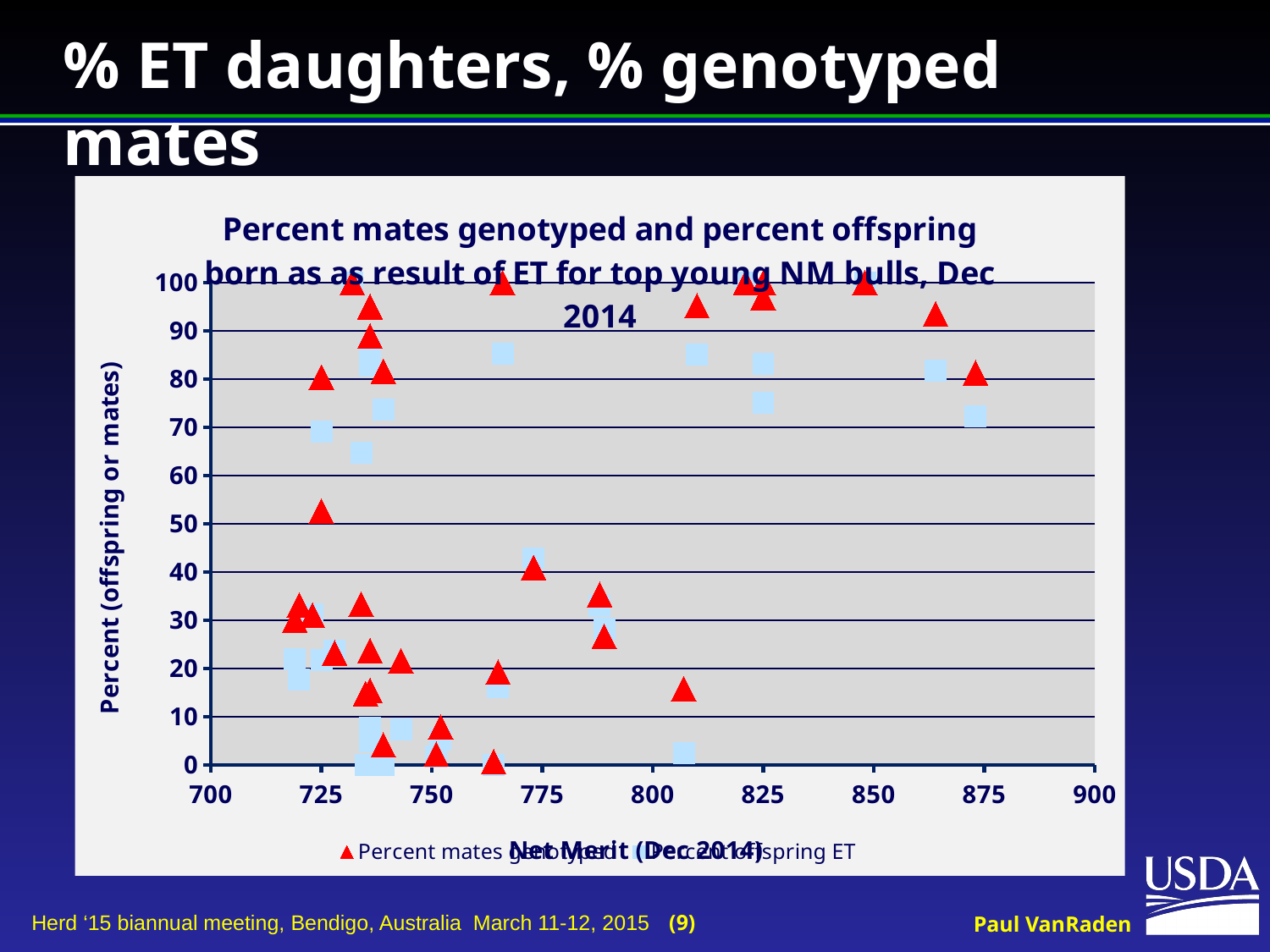
Is the Percent offspring ET value for the bull with Net Merit near 775 greater or less than 50? less Is the Percent mates genotyped value for the bull with Net Merit near 850 greater or less than 90? greater How many data series does the chart's legend list? 2 Is the lowest plotted value for Percent offspring ET greater or less than 10? less What kind of chart is shown on the slide? scatter chart What is the title of the chart? Percent mates genotyped and percent offspring born as as result of ET for top young NM bulls, Dec 2014 Which series is plotted with red triangles? Percent mates genotyped